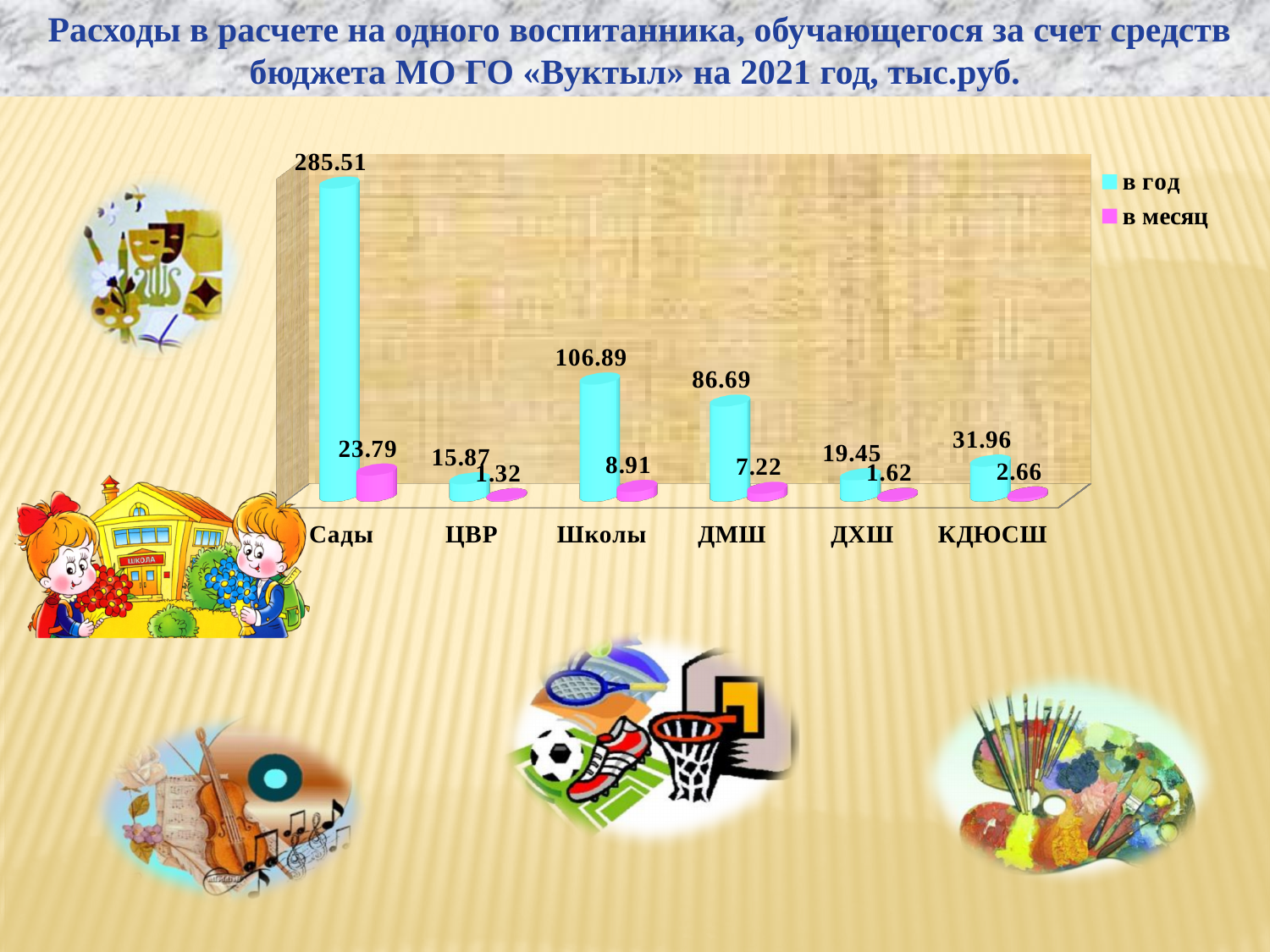
What is the value for Сады in the series «в год»? 285.51 How many categories are shown on the x axis? 6 Which colour represents the series «в месяц» in the legend? Pink What is the value for Школы in the series «в месяц»? 8.91 What kind of chart is shown on the slide? Bar chart What is the value for КДЮСШ in the series «в месяц»? 2.66 How many series does the legend list? 2 Which category has the lowest value in the series «в месяц»? ЦВР What is the value for ДМШ in the series «в год»? 86.69 Which category has the highest value in the series «в год»? Сады What is the difference between the «в год» values for Школы and ДМШ? 20.20 Which is larger in the series «в год»: ДХШ or КДЮСШ? КДЮСШ